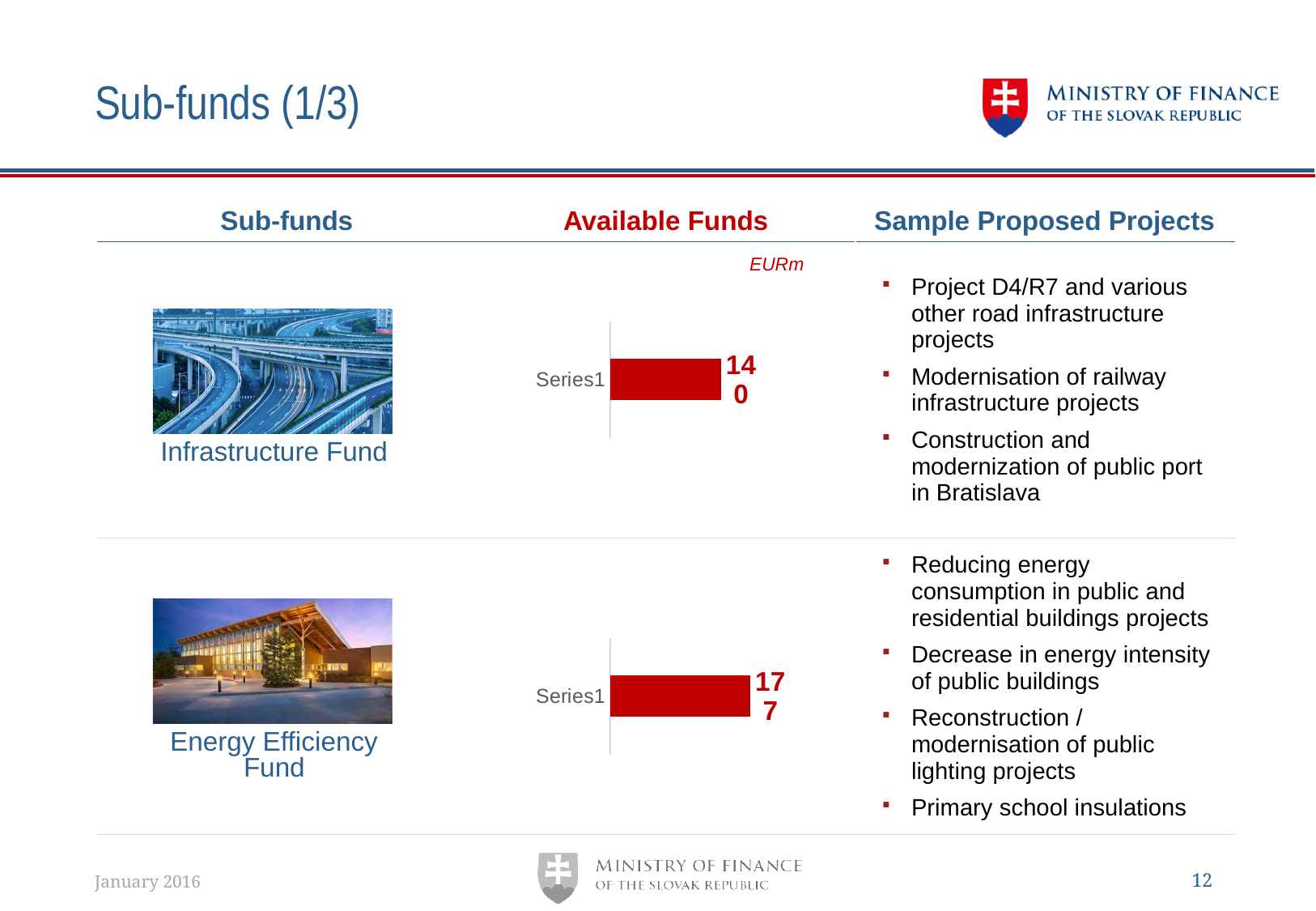
Which chart shows the larger available funds value, the Infrastructure Fund chart or the Energy Efficiency Fund chart? Energy Efficiency Fund What is the category label on the bar in the Infrastructure Fund chart? Series1 In the Energy Efficiency Fund chart, what value is shown for Series1? 177 How many bars are plotted in the Energy Efficiency Fund chart? 1 In the Infrastructure Fund chart, what value is shown for Series1? 140 How many bars are plotted in the Infrastructure Fund chart? 1 What kind of chart is used to show the available funds for the Energy Efficiency Fund? bar chart What kind of chart is used to show the available funds for the Infrastructure Fund? bar chart What is the difference between the Energy Efficiency Fund value and the Infrastructure Fund value? 37 What unit is indicated above the Available Funds charts? EURm